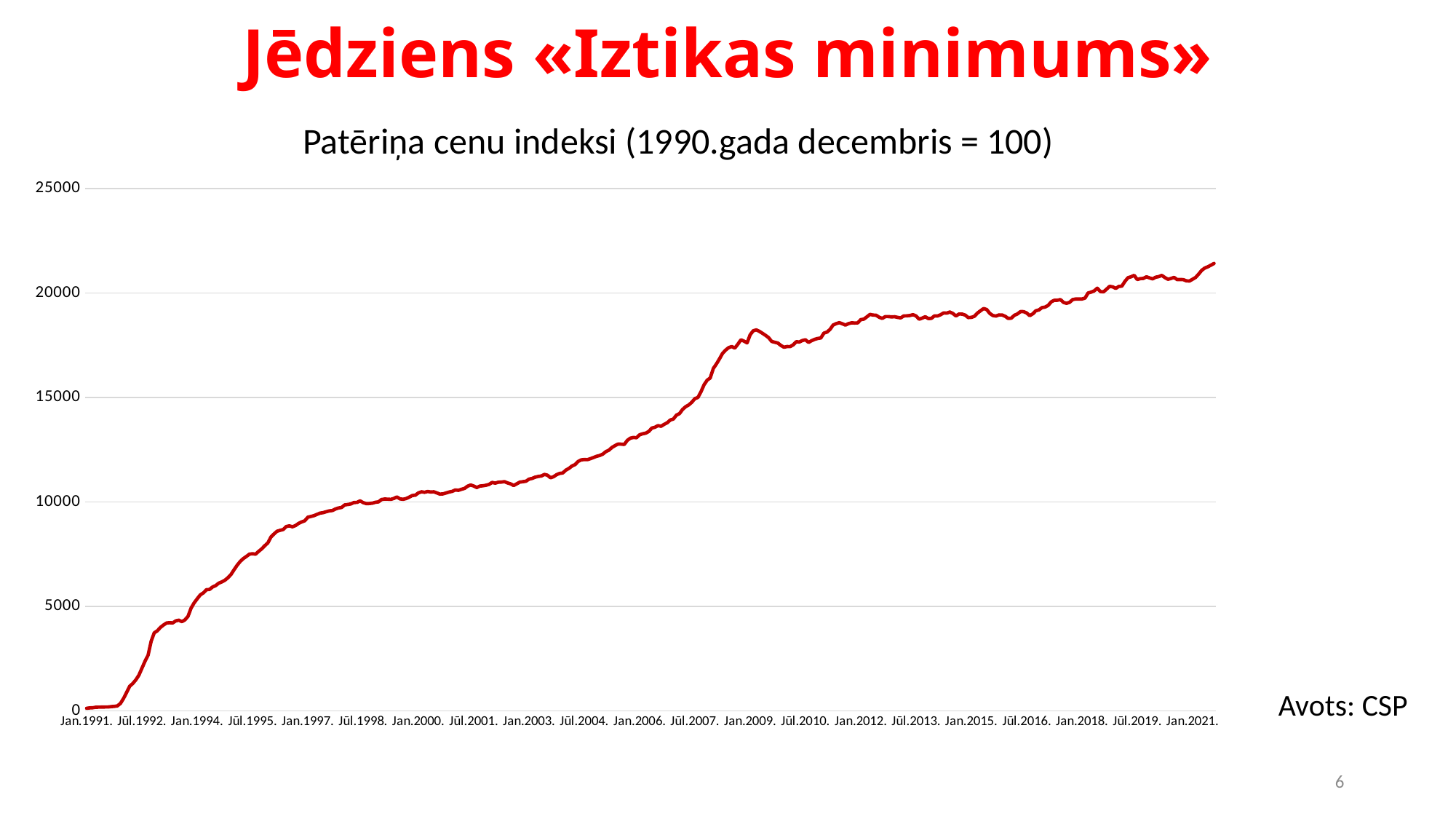
Is the value at Jan.2009 greater or less than 15000? greater What is the title of the chart? Patēriņa cenu indeksi (1990.gada decembris = 100) Is the value at Jan.2012 greater or less than 20000? less Which is larger, the value at Jan.2009 or the value at Jan.2003? Jan.2009 Overall, do the values rise or fall from Jan.1991 to Jan.2021? rise Is the value at Jan.2021 greater or less than 20000? greater At which labelled date on the x axis is the index lowest? Jan.1991 What source is cited for the chart data? CSP What kind of chart is shown on the slide? line chart